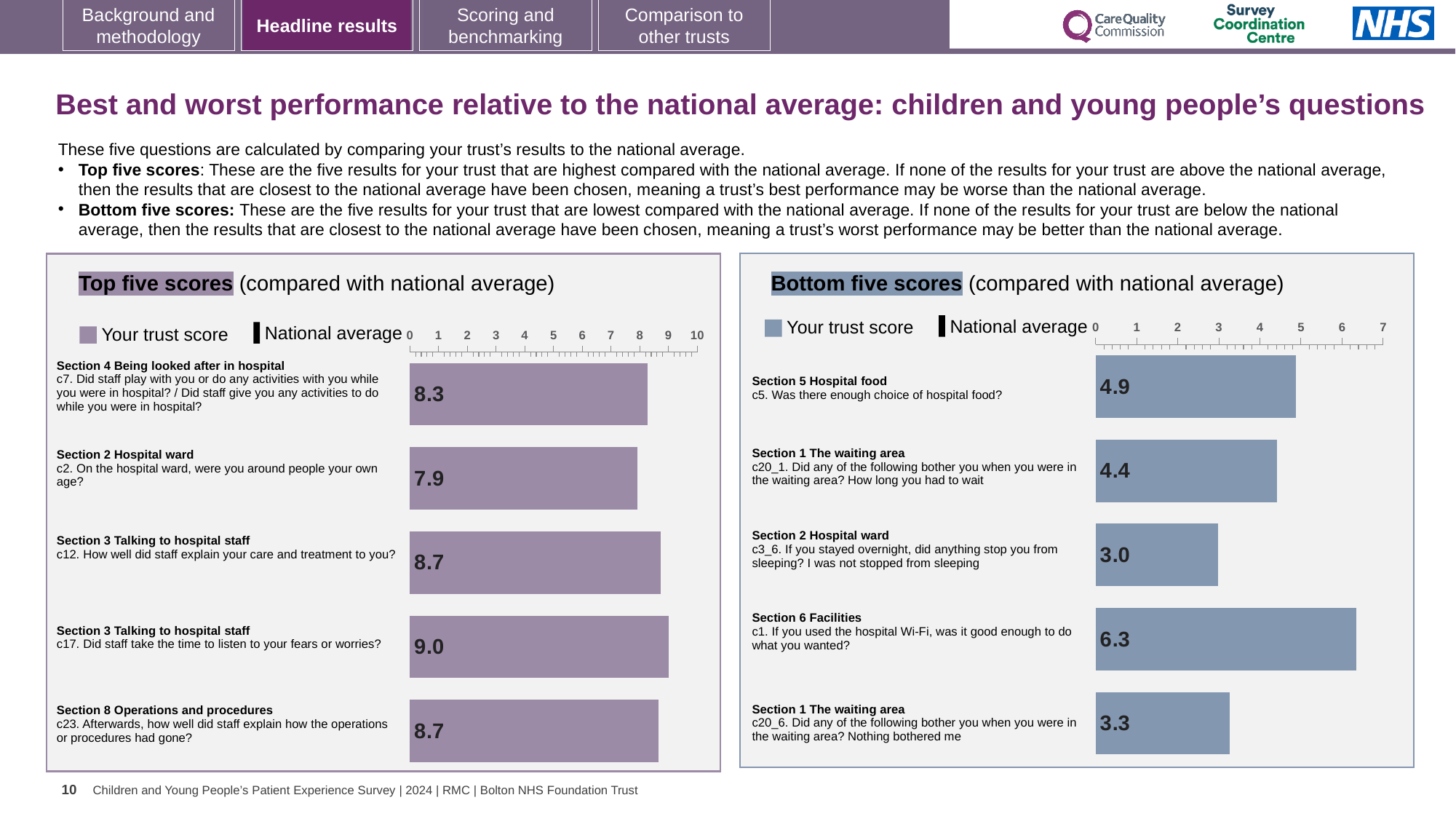
In the Bottom five scores chart, what is the trust score for c5 (Was there enough choice of hospital food?)? 4.9 In the Top five scores chart, what is the difference between the trust scores for c17 and c2? 1.1 In the Bottom five scores chart, which has the larger trust score: c5 or c20_1? c5 In the Top five scores chart, which question has the highest trust score? c17. Did staff take the time to listen to your fears or worries? How many questions are shown in the Bottom five scores chart? 5 What type of chart is the Top five scores chart? Bar chart How many series does the legend of the Top five scores chart list? 2 In the Bottom five scores chart, which question has the lowest trust score? c3_6. If you stayed overnight, did anything stop you from sleeping? I was not stopped from sleeping In the Bottom five scores chart, what is the difference between the trust scores for c1 and c20_6? 3.0 In the Top five scores chart, what is the trust score for c2 (On the hospital ward, were you around people your own age?)? 7.9 In the Bottom five scores chart, what is the trust score for c1 (If you used the hospital Wi-Fi, was it good enough to do what you wanted?)? 6.3 In the Top five scores chart, what is the trust score for c17 (Did staff take the time to listen to your fears or worries?)? 9.0